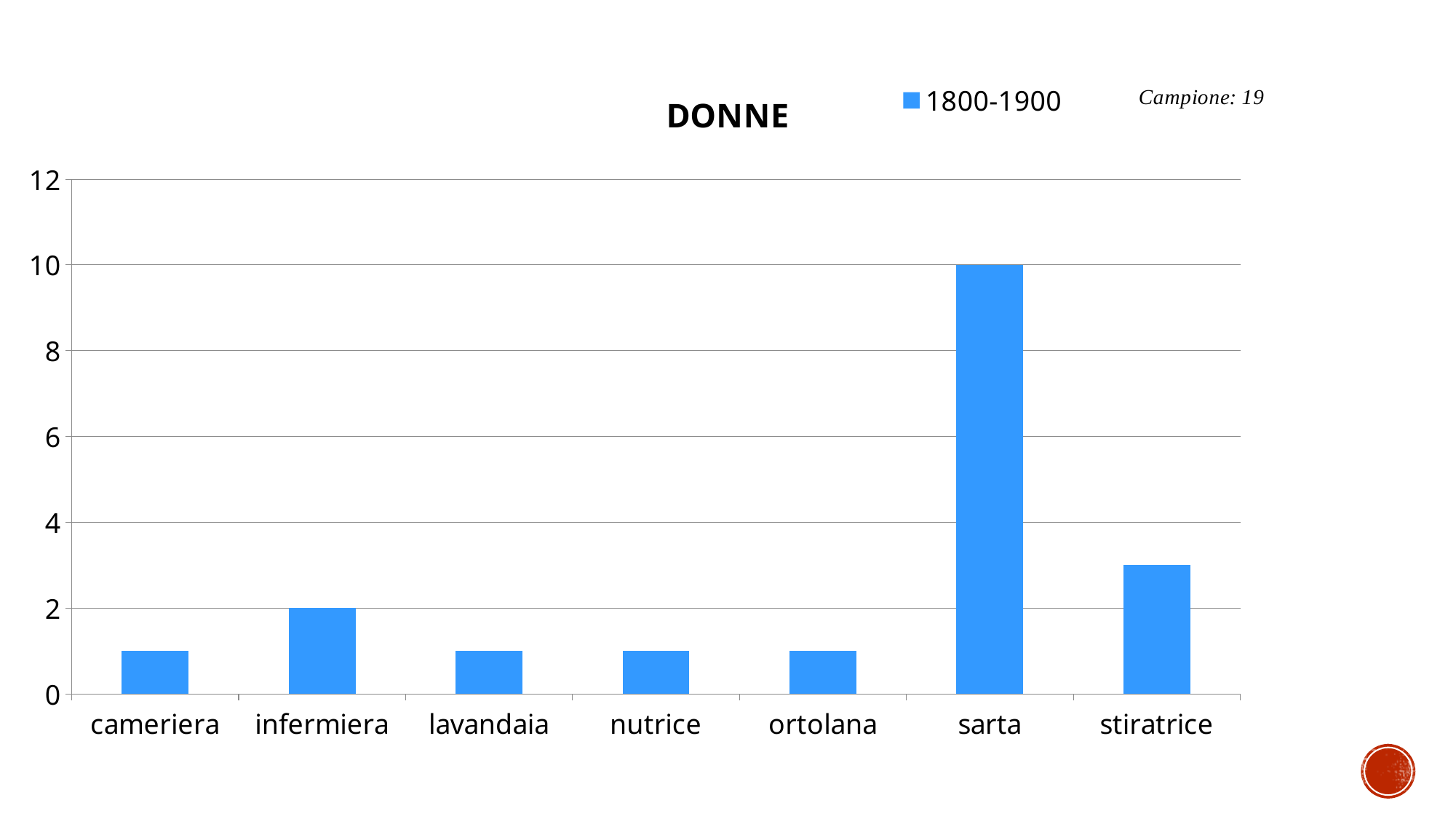
What is the value for sarta? 10 What is the value for infermiera? 2 What is the difference between the values for sarta and infermiera? 8 What is the title of the chart? DONNE What type of chart is shown on the slide? bar chart Which is larger, the value for sarta or the value for stiratrice? sarta What series does the legend list? 1800-1900 Is the value for stiratrice greater or less than 4? less How many categories are shown on the x axis? 7 Which category has the highest value? sarta Is the value for cameriera greater or less than 2? less How many series does the legend list? 1